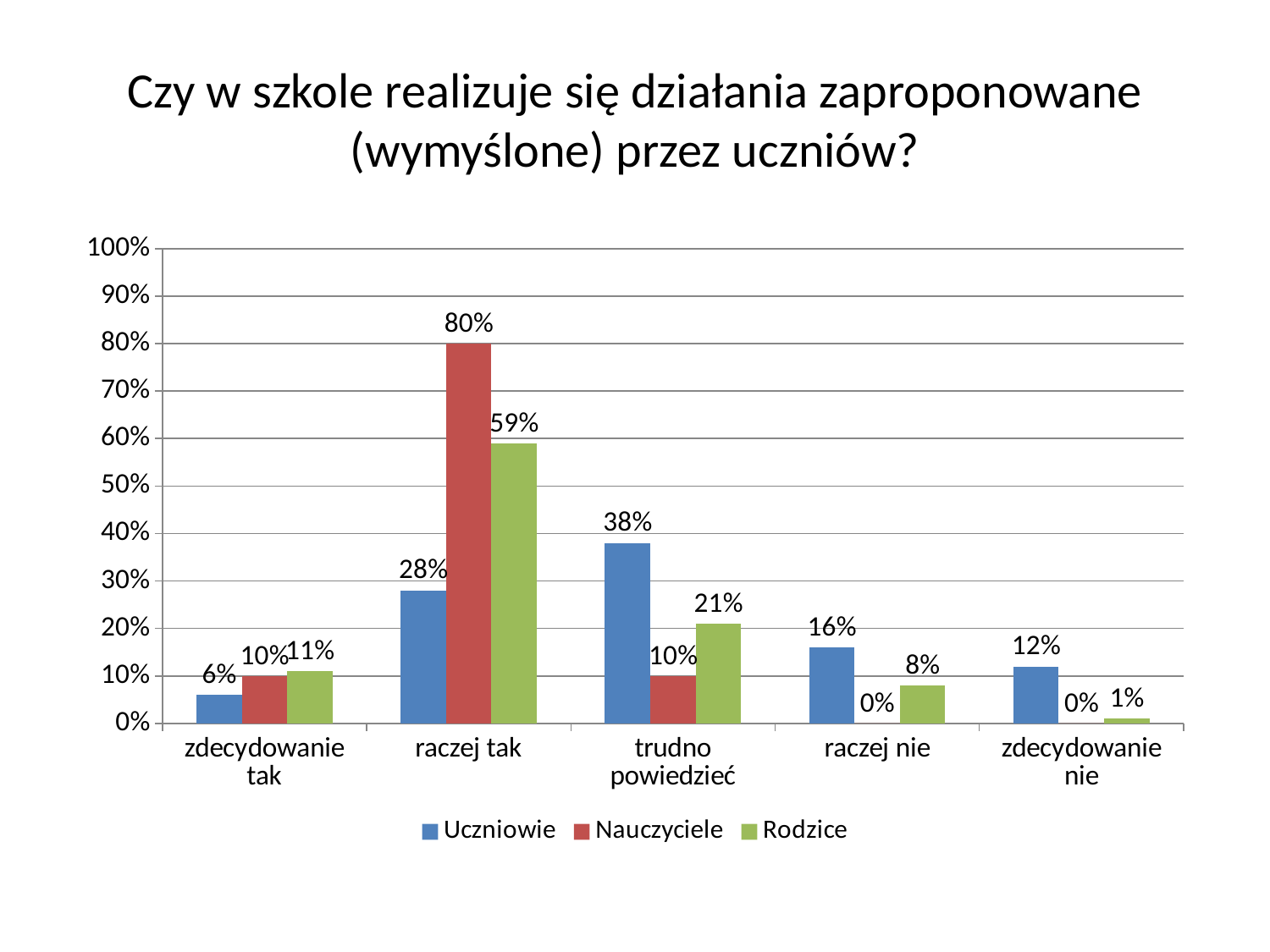
What is the value for Rodzice in the 'zdecydowanie nie' category? 1% Which is larger in the 'raczej nie' category: Uczniowie or Rodzice? Uczniowie Which category has the lowest value for Rodzice? zdecydowanie nie What is the difference between the Nauczyciele and Rodzice values in the 'raczej tak' category? 21% How many categories are shown on the x axis? 5 Is the value for Rodzice in 'raczej tak' greater or less than 50%? greater What kind of chart is shown on the slide? bar chart Which series is shown in red? Nauczyciele What is the value for Nauczyciele in the 'raczej tak' category? 80% What is the value for Uczniowie in the 'trudno powiedzieć' category? 38% How many series does the legend list? 3 Which category has the highest value for Uczniowie? trudno powiedzieć